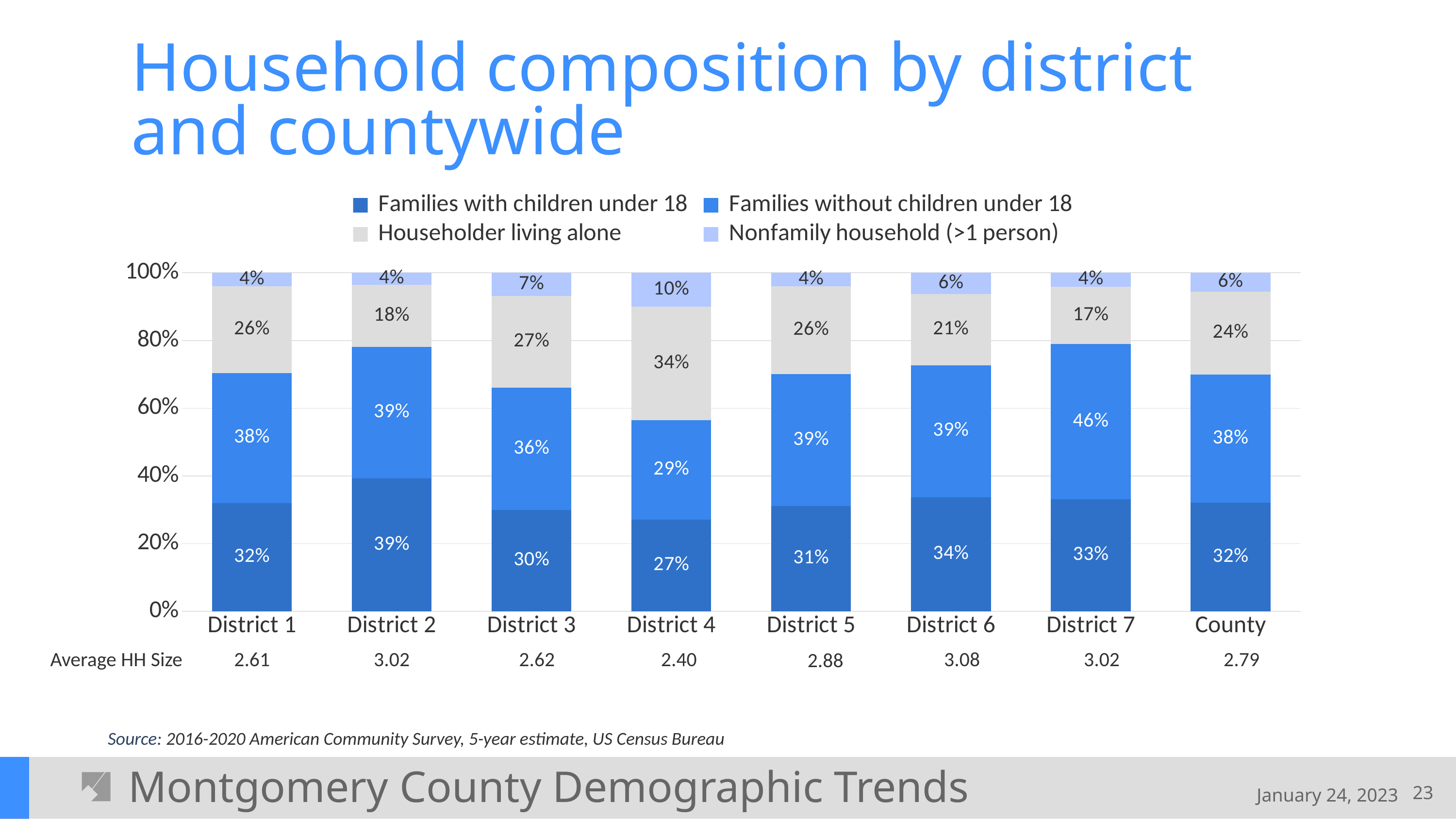
What percentage of County households are nonfamily households (>1 person)? 6% Is the share of families with children under 18 larger in District 6 or District 3? District 6 Which district has the highest share of families without children under 18? District 7 Which category has the highest share of nonfamily households (>1 person)? District 4 What kind of chart is shown on the slide? Stacked bar chart What is the share of families with children under 18 in District 2? 39% What percentage of households in District 4 are householders living alone? 34% How many series does the legend list? 4 What is the Average HH Size shown for District 6? 3.08 What is the difference in the householder living alone share between District 4 and District 7? 17 percentage points Which category has the lowest share of families with children under 18? District 4 How many categories are shown on the x axis? 8